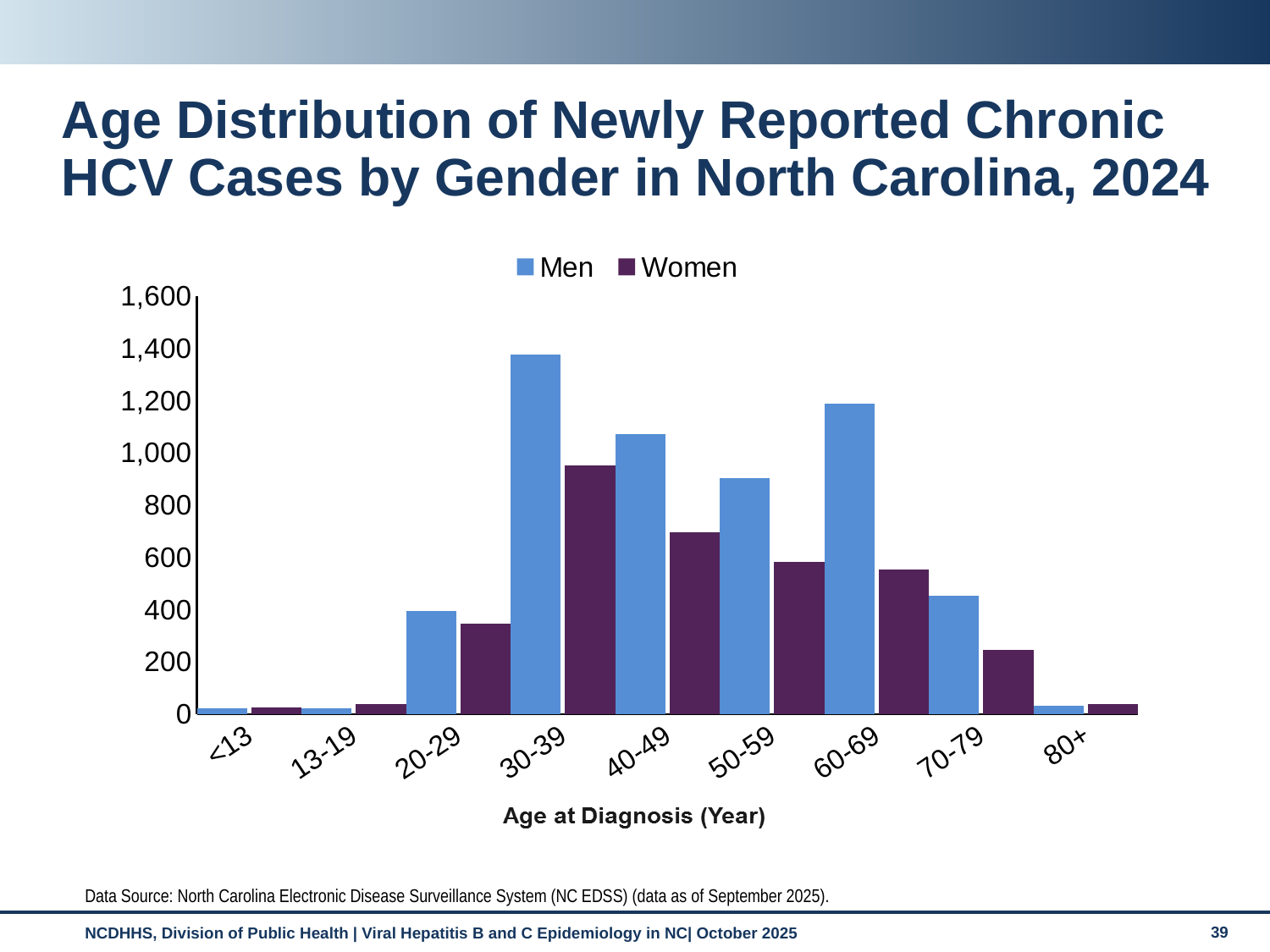
Is the value for Men in the 30-39 age group greater or less than 1,200? greater How many age groups are shown on the x axis? 9 How many series does the legend list? 2 Is the value for Women in the 30-39 age group greater or less than 1,000? less For Men, which is larger, the value for 30-39 or the value for 60-69? 30-39 Which age group has the highest value for Women? 30-39 Is the value for Men in the 60-69 age group greater or less than 1,000? greater In the 40-49 age group, which is larger, the value for Men or the value for Women? Men Which age group has the highest value for Men? 30-39 What kind of chart is shown on the slide? bar chart What is the title of the x axis? Age at Diagnosis (Year)